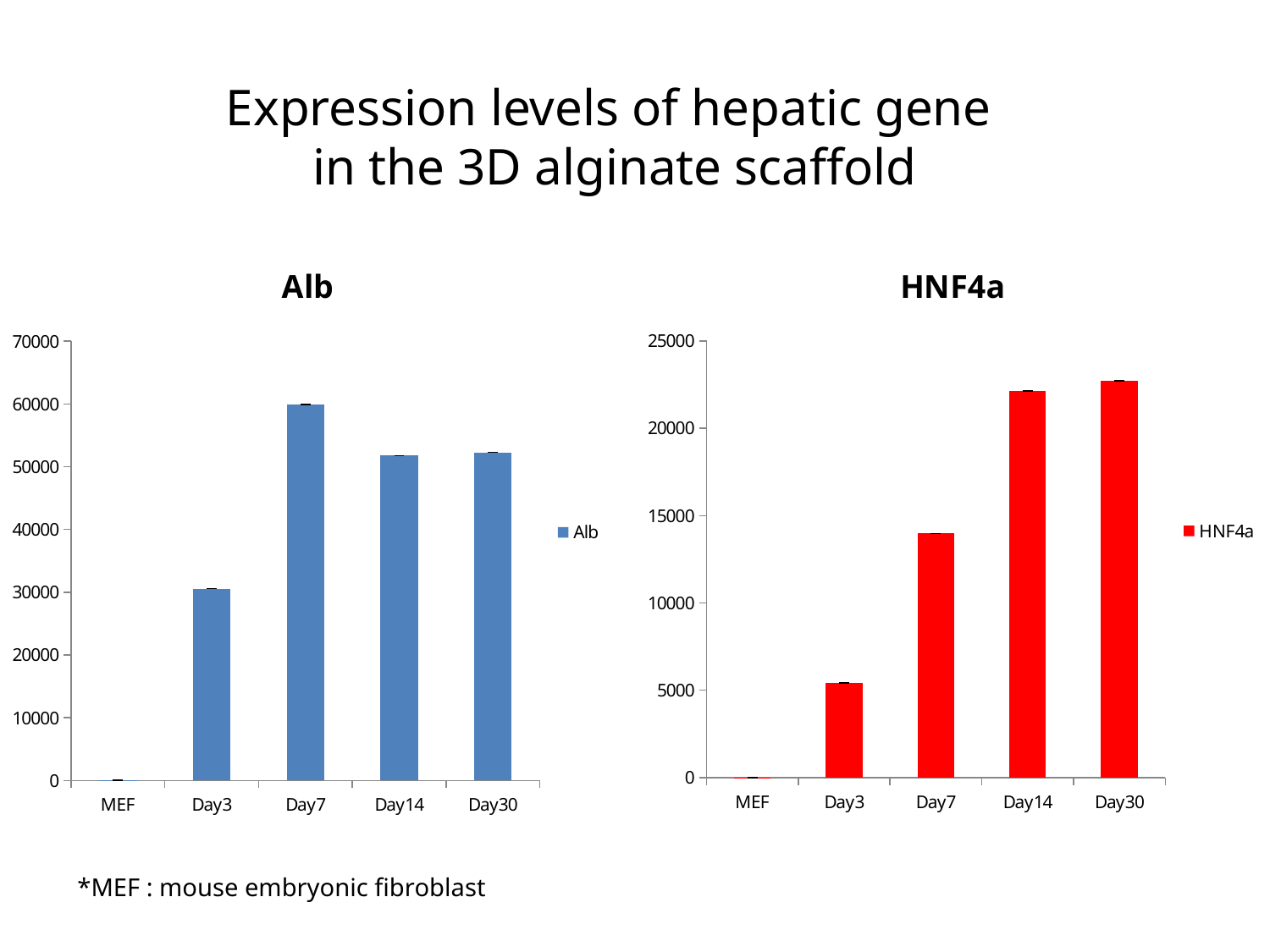
In the Alb chart, which is larger, the value for Day7 or the value for Day3? Day7 How many categories are shown on the x axis of the HNF4a chart? 5 In the HNF4a chart, is the value for Day7 greater or less than 15000? less In the Alb chart, which category has the lowest value? MEF What kind of chart is the Alb chart? bar chart How many series does the legend of the HNF4a chart list? 1 In the Alb chart, which category has the highest value? Day7 In the HNF4a chart, which category has the lowest value? MEF In the HNF4a chart, is the value for Day3 greater or less than 5000? greater In the HNF4a chart, which is larger, the value for Day14 or the value for Day7? Day14